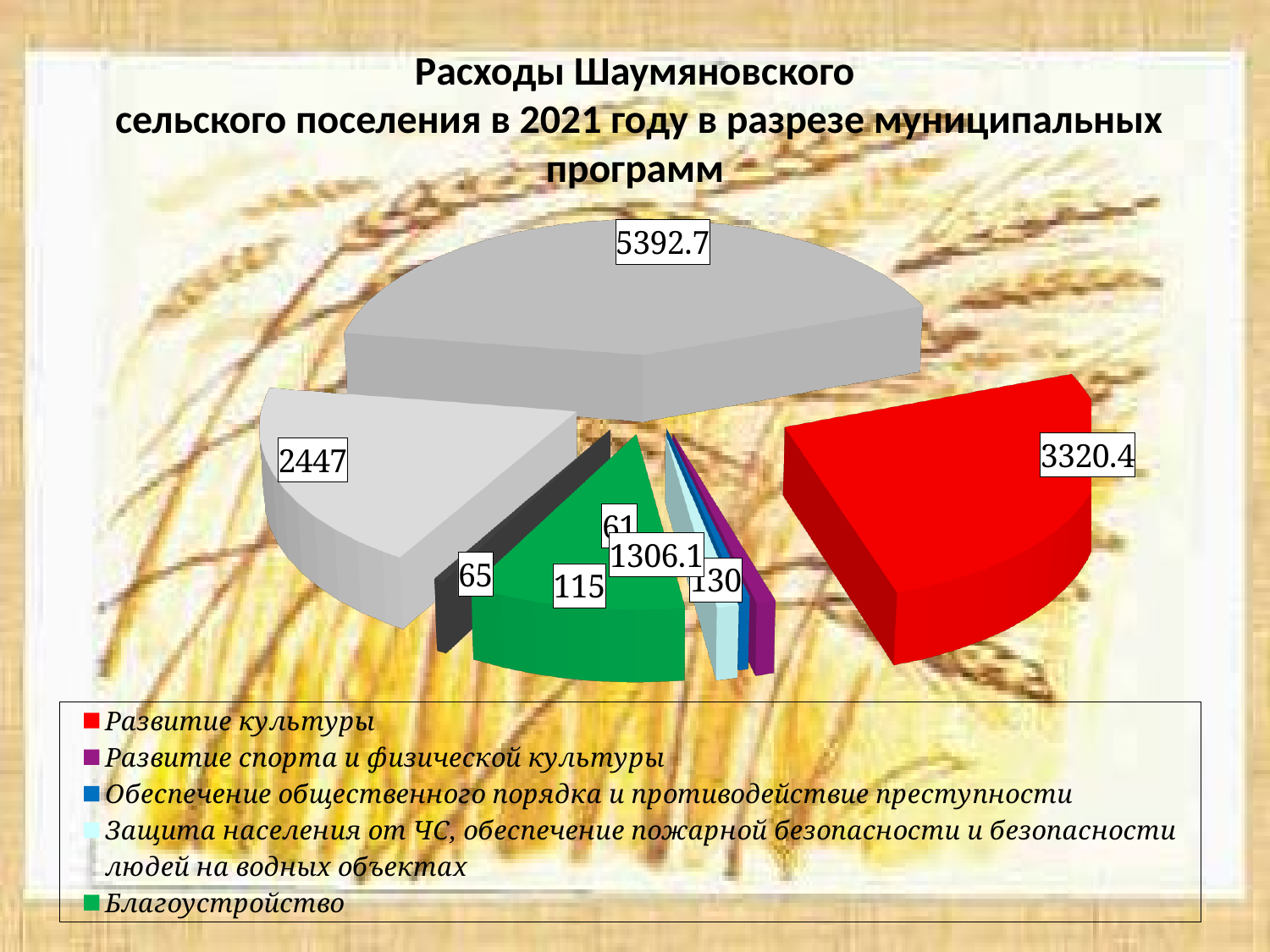
What is the difference between the largest slice (5392.7) and the Развитие культуры slice (3320.4)? 2072.3 What is the value shown for Развитие культуры (the red slice)? 3320.4 What is the difference between the Развитие культуры slice (3320.4) and the slice labelled 2447? 873.4 Which is larger: the slice labelled 5392.7 or the Развитие культуры slice? the slice labelled 5392.7 Which year does the chart title say the expenditures refer to? 2021 What is the smallest value printed on the pie chart? 61 What colour represents Благоустройство in the legend? green What kind of chart is shown on the slide? pie chart How many data labels are printed on the pie chart? 8 How many entries does the legend list? 5 Is the value for Развитие культуры greater or less than 3000? greater What is the value of the largest slice in the pie chart? 5392.7